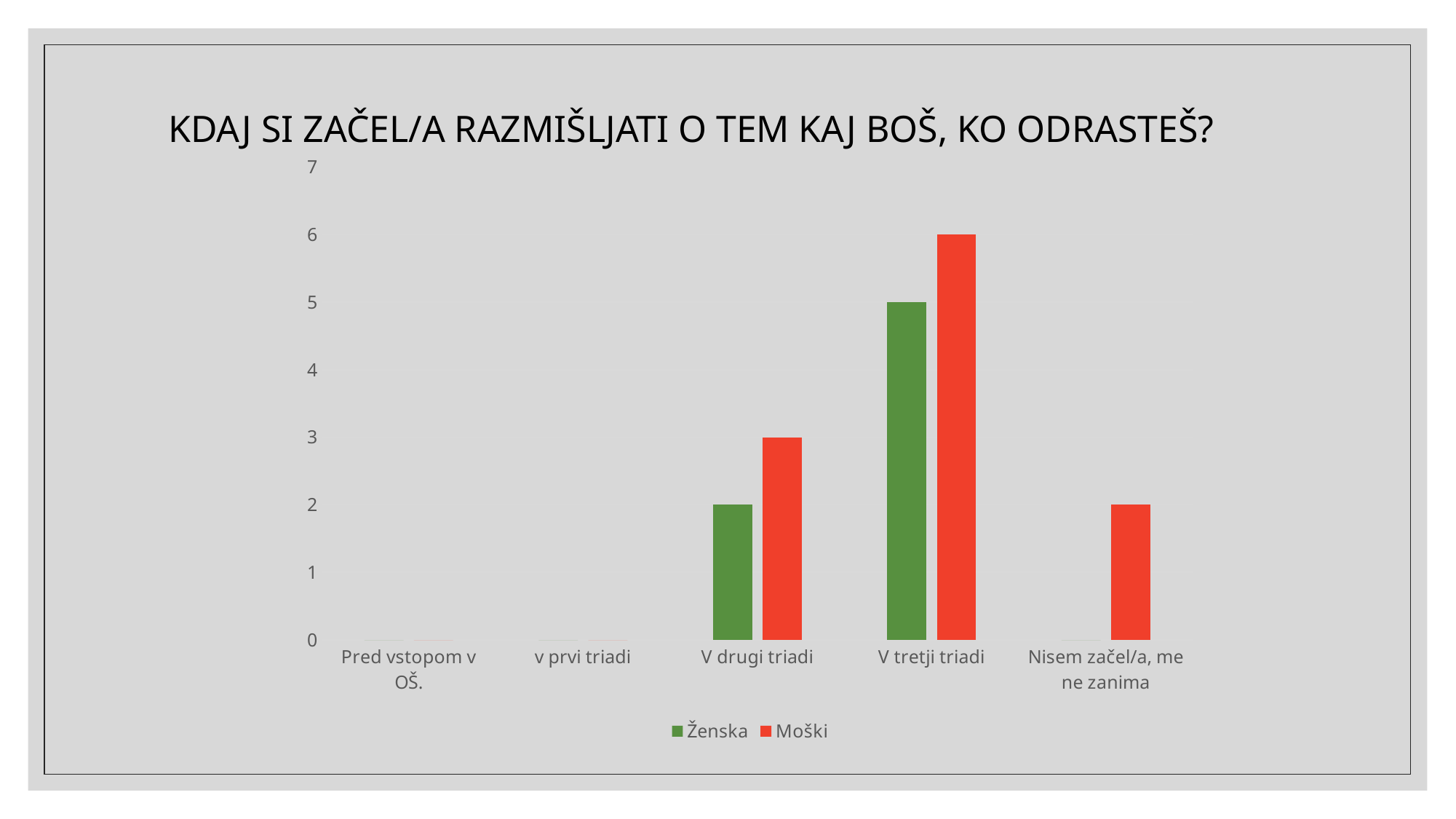
What is the value for Moški in the category V tretji triadi? 6 In the category V drugi triadi, which series has the larger value, Ženska or Moški? Moški How many categories are shown on the x axis? 5 What is the value for Moški in the category V drugi triadi? 3 How many series does the legend list? 2 What is the value for Moški in the category Nisem začel/a, me ne zanima? 2 What is the difference between the Moški and Ženska values in the category V tretji triadi? 1 What kind of chart is shown on the slide? bar chart Which series is shown in green in the legend? Ženska Which category has the highest value for the Moški series? V tretji triadi What is the value for Ženska in the category V drugi triadi? 2 What is the value for Ženska in the category V tretji triadi? 5